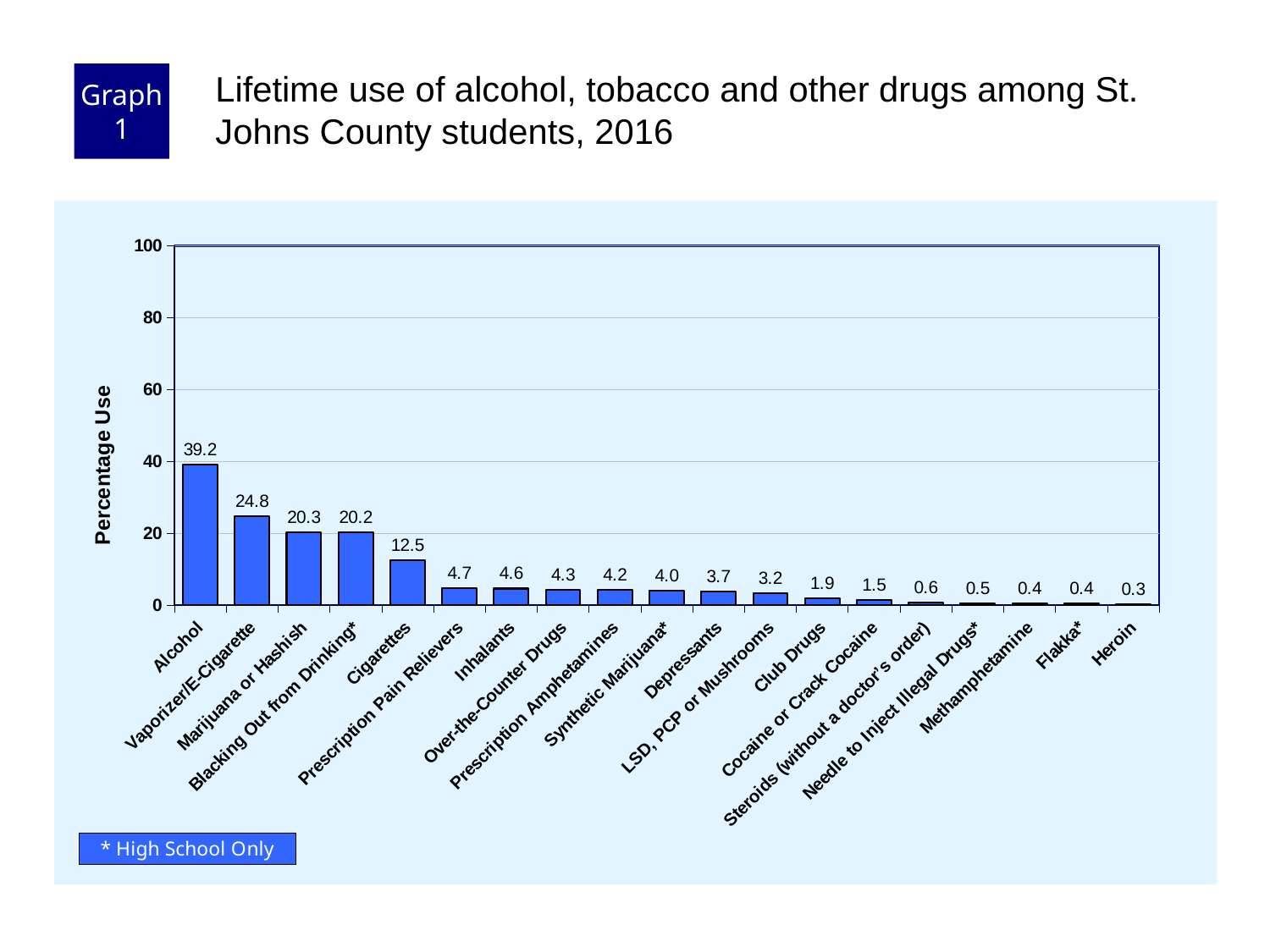
What is the difference between the values for Alcohol and Vaporizer/E-Cigarette? 14.4 What is the value for Vaporizer/E-Cigarette? 24.8 Which category has the lowest value? Heroin What is the value for Heroin? 0.3 Which category has the highest value? Alcohol What is the value for Alcohol? 39.2 How many categories are shown on the x axis? 19 What is the value for Cigarettes? 12.5 What is the label of the y axis? Percentage Use Do the values rise or fall moving from left to right along the x axis? Fall Which is larger, the value for Cigarettes or the value for Prescription Pain Relievers? Cigarettes What kind of chart is shown on the slide? Bar chart